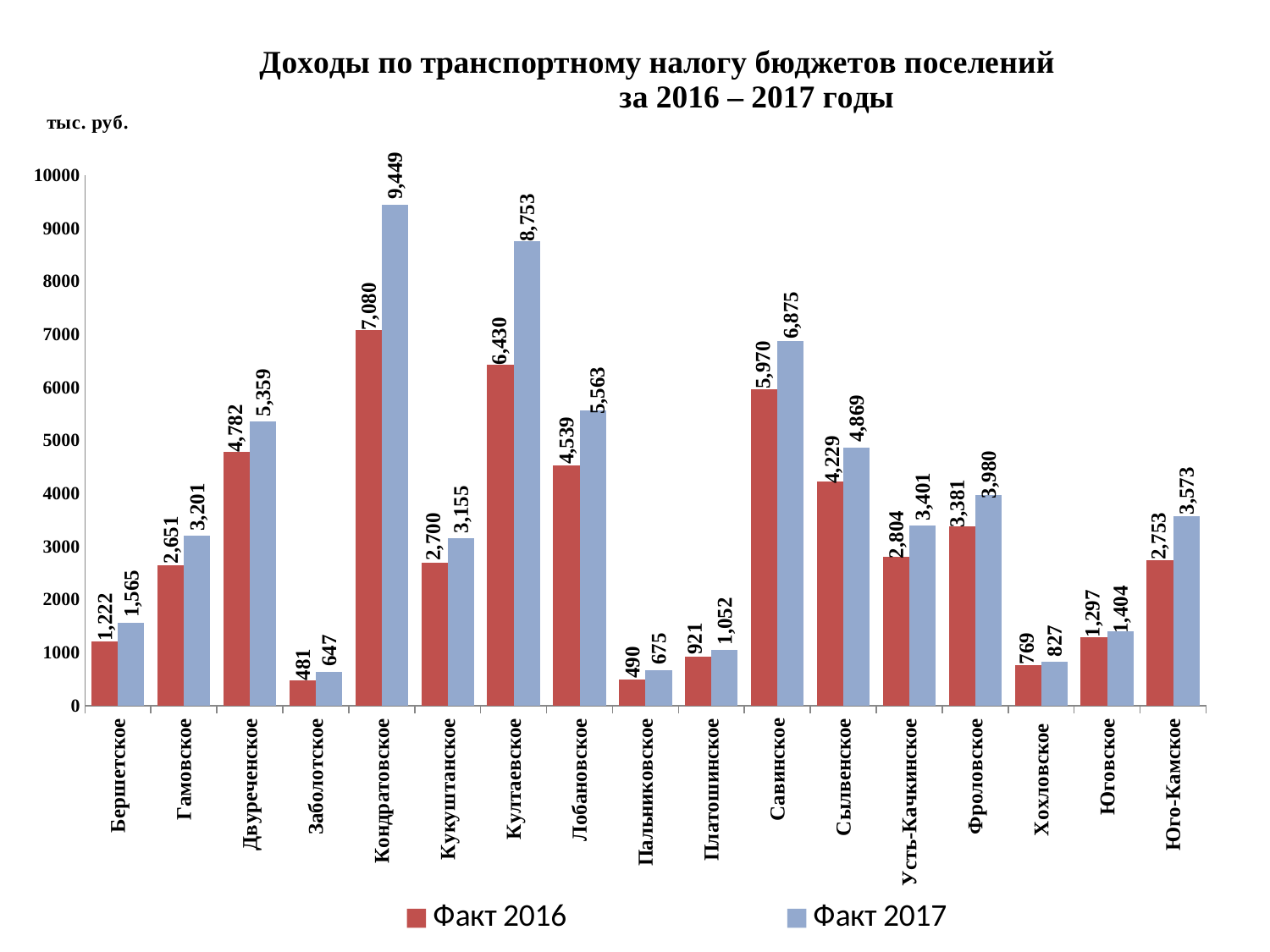
What is the difference between the Факт 2017 and Факт 2016 values for Кондратовское? 2,369 Which is larger: the Факт 2016 value for Лобановское or the Факт 2016 value for Сылвенское? Лобановское Is the Факт 2017 value for Фроловское greater or less than 4000? less What is the Факт 2016 value for Савинское? 5,970 How many series does the legend list? 2 Which settlement has the lowest Факт 2016 value? Заболотское Which settlement has the highest Факт 2017 value? Кондратовское How many settlements are shown on the x axis? 17 What is the Факт 2017 value for Кондратовское? 9,449 What type of chart is shown on the slide? bar chart What is the difference between the Факт 2017 and Факт 2016 values for Култаевское? 2,323 What is the Факт 2016 value for Усть-Качкинское? 2,804